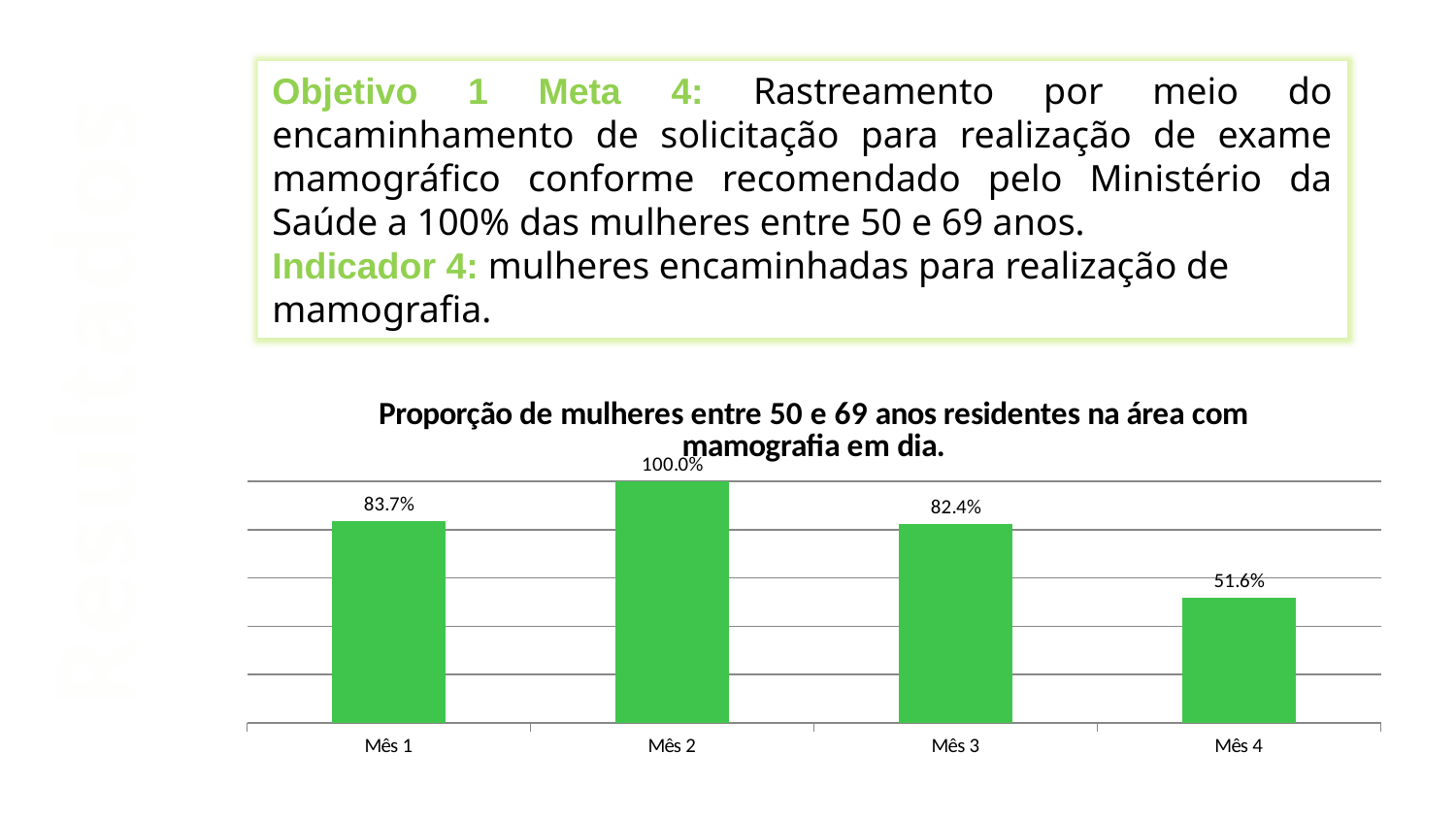
What is the difference between the values for Mês 1 and Mês 3? 1.3% What is the value for Mês 1? 83.7% Which month has the lowest value? Mês 4 What is the difference between the values for Mês 2 and Mês 4? 48.4% What is the value for Mês 3? 82.4% What kind of chart is shown on the slide? Bar chart What is the value for Mês 2? 100.0% What is the value for Mês 4? 51.6% What is the title of the chart? Proporção de mulheres entre 50 e 69 anos residentes na área com mamografia em dia. Which is larger, the value for Mês 3 or the value for Mês 4? Mês 3 Which month has the highest value? Mês 2 How many months are shown on the x axis? 4